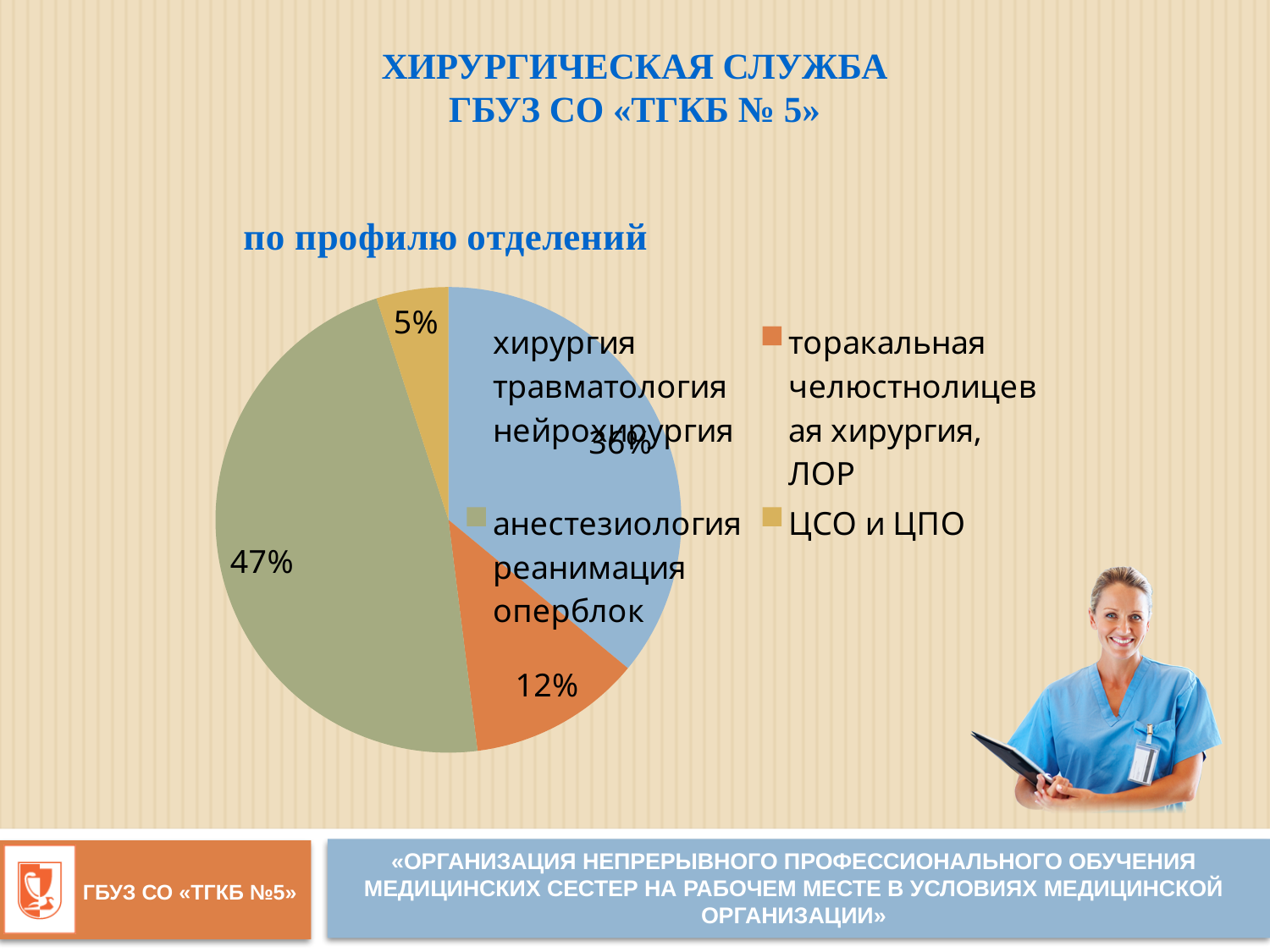
How many slices does the pie chart have? 4 Which is larger: the slice for "хирургия травматология нейрохирургия" or the slice for "торакальная челюстнолицевая хирургия, ЛОР"? хирургия травматология нейрохирургия What share of the pie does "анестезиология реанимация оперблок" have? 47% What kind of chart is shown on the slide? pie chart What is the title of the pie chart? по профилю отделений What share of the pie does "торакальная челюстнолицевая хирургия, ЛОР" have? 12% What share of the pie does "ЦСО и ЦПО" have? 5% Which category has the smallest slice of the pie? ЦСО и ЦПО Which category has the largest slice of the pie? анестезиология реанимация оперблок What share of the pie does "хирургия травматология нейрохирургия" have? 36% What is the difference in percentage points between "анестезиология реанимация оперблок" and "торакальная челюстнолицевая хирургия, ЛОР"? 35 What colour is the slice for "ЦСО и ЦПО"? yellow